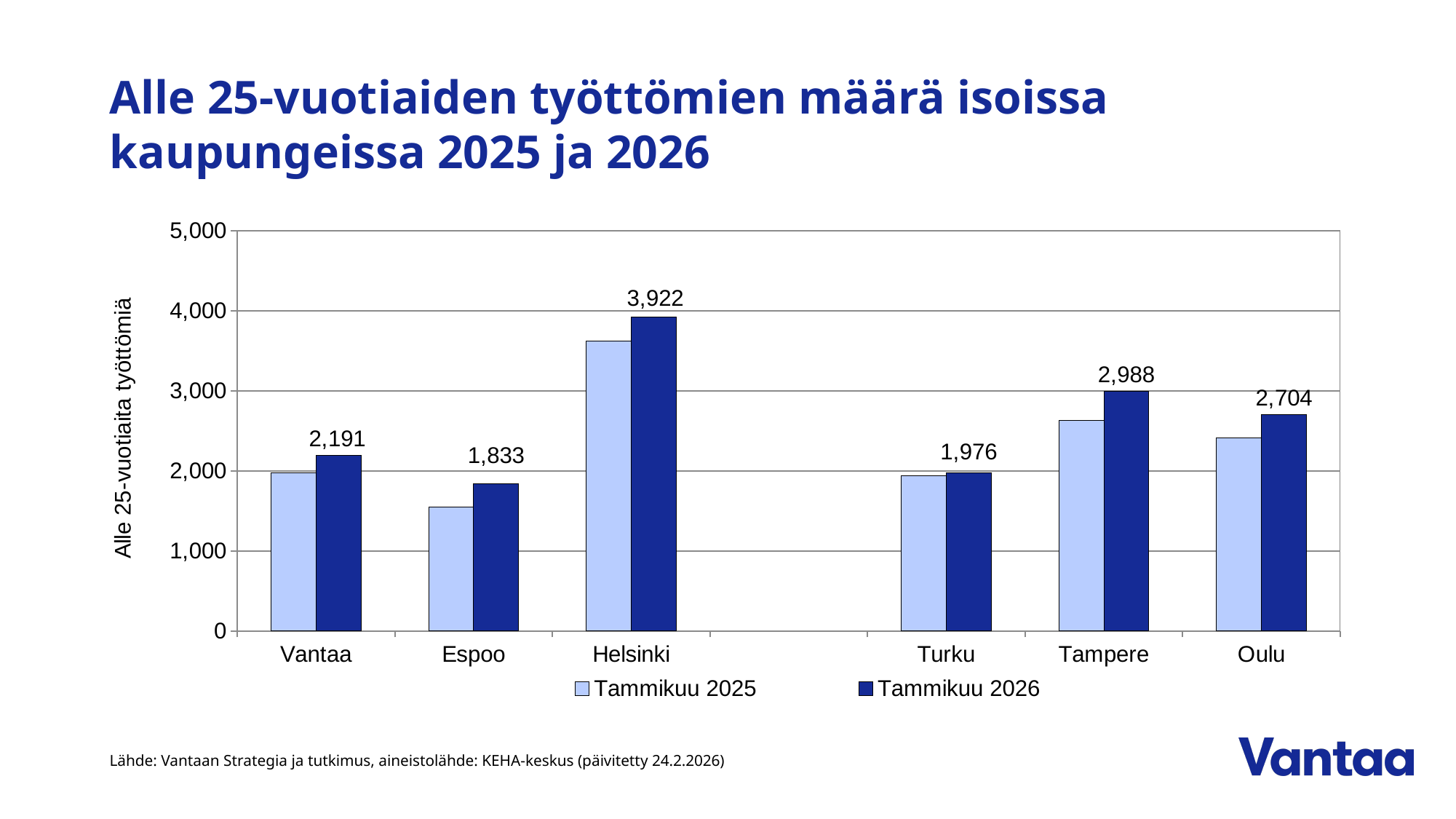
What is the value for Vantaa in Tammikuu 2026? 2,191 Which city has the lowest value in Tammikuu 2026? Espoo Which city has the highest value in Tammikuu 2026? Helsinki What is the value for Oulu in Tammikuu 2026? 2,704 How many cities are shown on the x axis? 6 Is the value for Espoo in Tammikuu 2025 greater or less than 2,000? less What kind of chart is shown on the slide? Bar chart What is the value for Helsinki in Tammikuu 2026? 3,922 Is the value for Helsinki in Tammikuu 2025 greater or less than 3,000? greater Which is larger in Tammikuu 2026, Turku or Espoo? Turku How many series does the legend list? 2 What is the difference between the Tammikuu 2026 values for Tampere and Oulu? 284